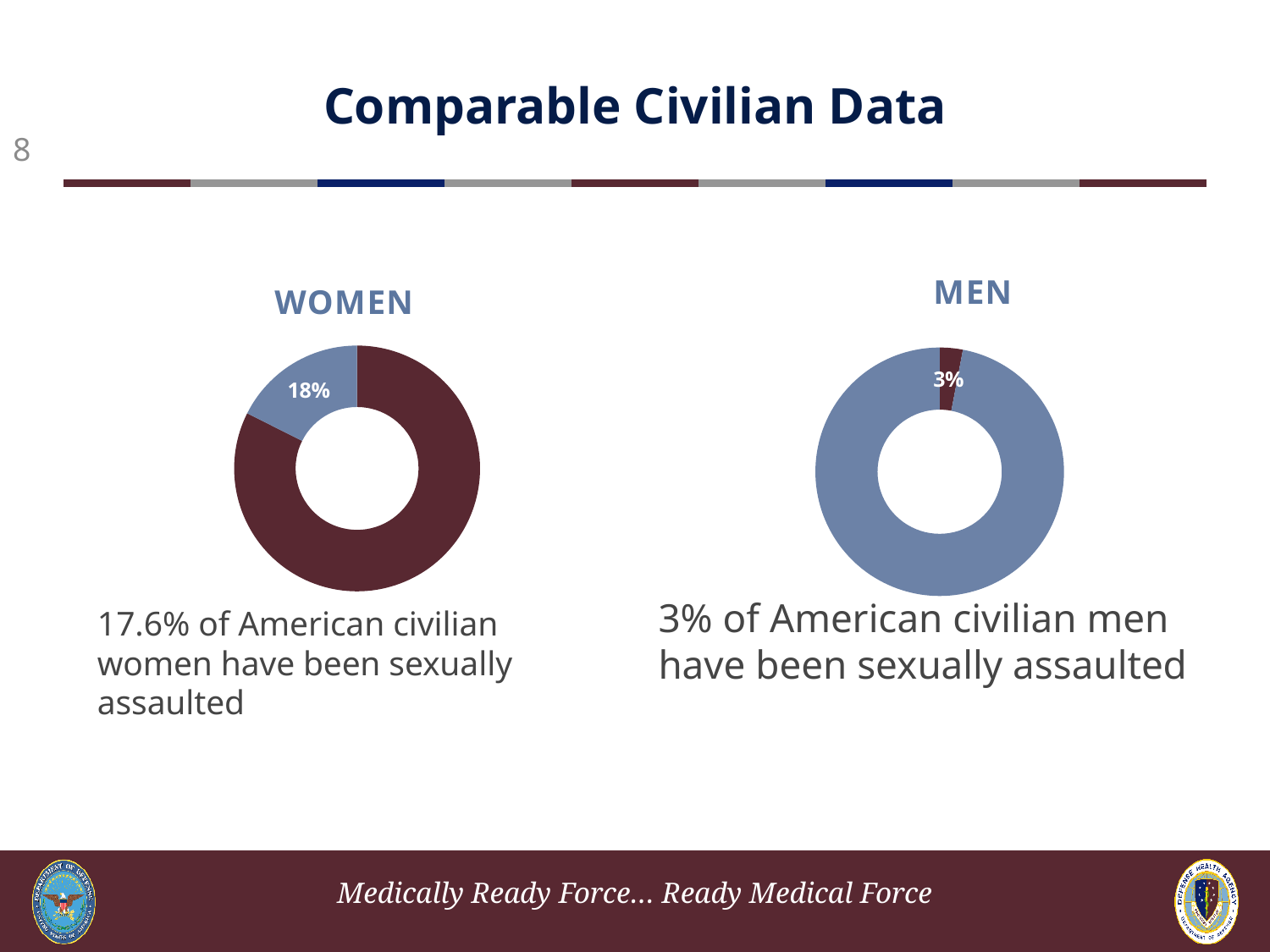
In the WOMEN chart, what colour is the slice labelled 18%? Blue In the MEN chart, what percentage is shown on the labelled slice? 3% In the WOMEN chart, what percentage is shown on the labelled slice? 18% What is the difference between the labelled value in the WOMEN chart (18%) and the labelled value in the MEN chart (3%)? 15 percentage points In the MEN chart, what share of the doughnut does the dark red slice represent? 3% Which is larger: the labelled slice in the WOMEN chart or the labelled slice in the MEN chart? WOMEN (18%) In the WOMEN chart, what share of the doughnut does the blue slice represent? 18% How many slices does the MEN doughnut chart have? 2 What kind of chart is the MEN chart? Doughnut chart How many slices does the WOMEN doughnut chart have? 2 What kind of chart is the WOMEN chart? Doughnut chart What is the title of the slide containing the two doughnut charts? Comparable Civilian Data